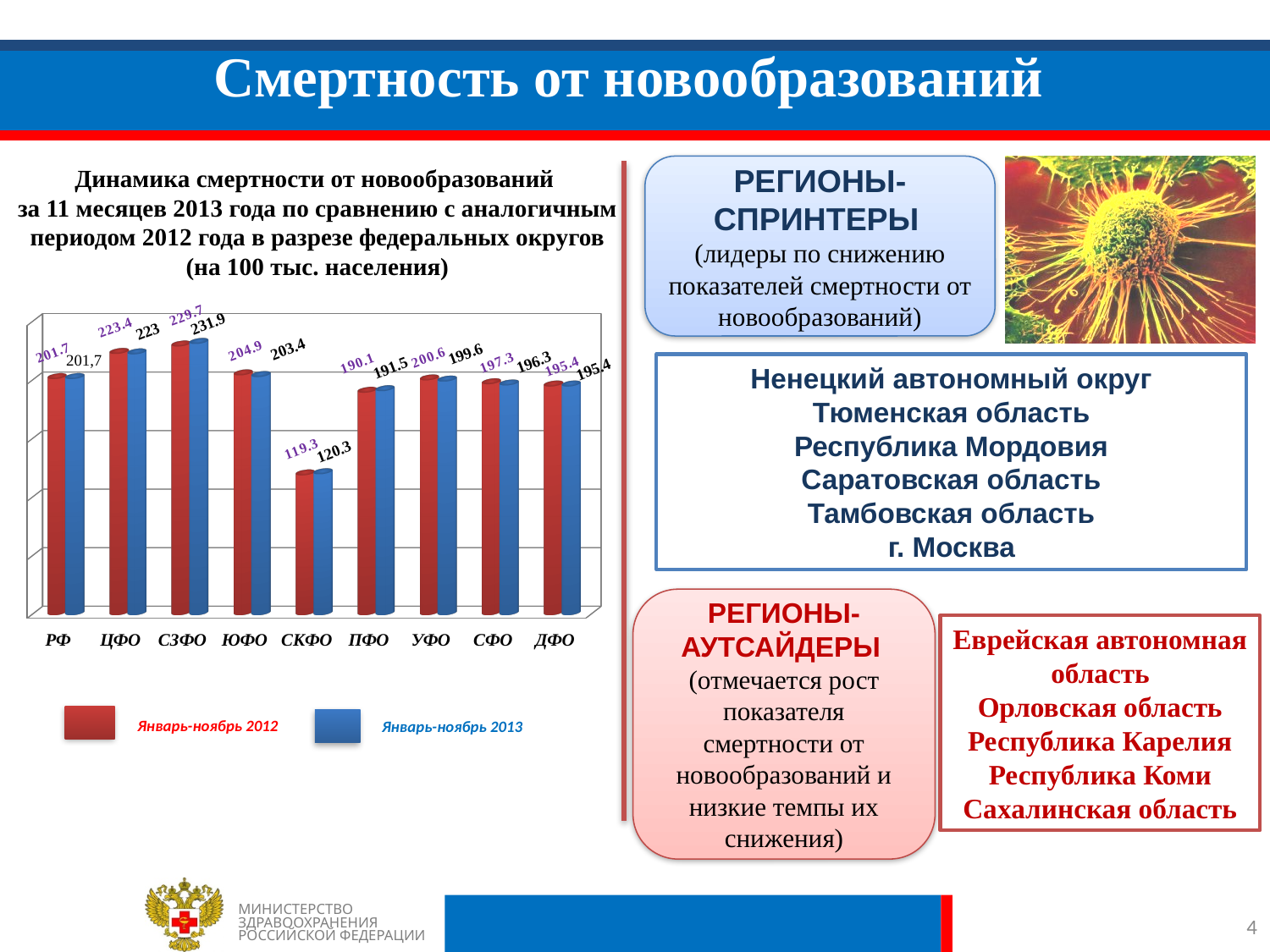
How many federal district categories are shown on the x axis of the chart? 9 What is the value for СКФО in the Январь-ноябрь 2012 series? 119.3 Which federal district has the highest value in the Январь-ноябрь 2012 series? СЗФО What is the difference between the Январь-ноябрь 2013 and Январь-ноябрь 2012 values for СЗФО? 2.2 How many series does the chart legend list? 2 Which federal district has the lowest value in the Январь-ноябрь 2013 series? СКФО What is the value for СЗФО in the Январь-ноябрь 2013 series? 231.9 What is the value for ЦФО in the Январь-ноябрь 2012 series? 223.4 What is the difference between the Январь-ноябрь 2012 value for ЦФО and the Январь-ноябрь 2012 value for СКФО? 104.1 Which colour represents the Январь-ноябрь 2013 series in the chart? blue What type of chart is shown on the slide? bar chart For ЮФО, which series has the larger value: Январь-ноябрь 2012 or Январь-ноябрь 2013? Январь-ноябрь 2012